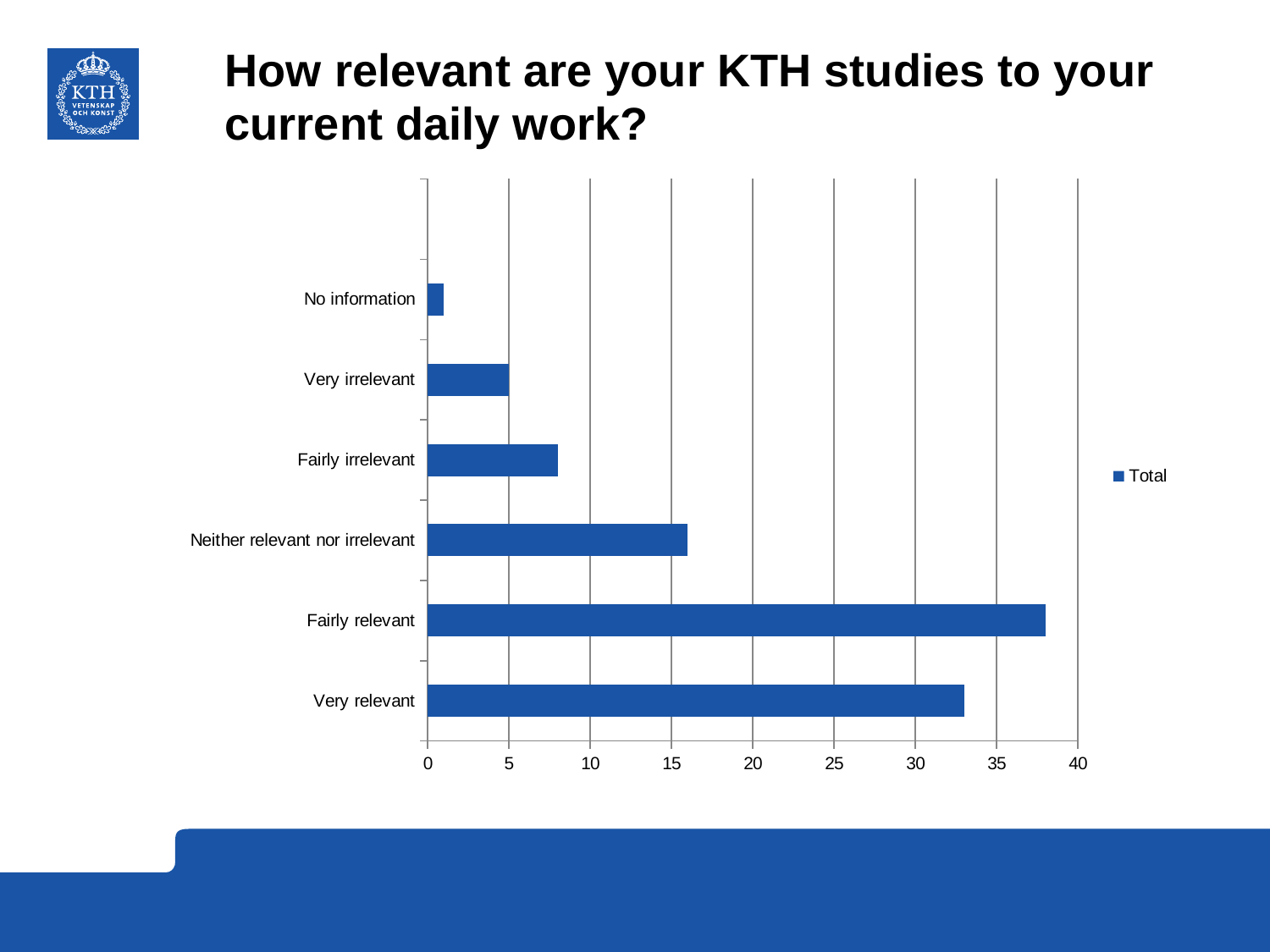
How many categories are shown on the chart? 6 Is the value for Fairly irrelevant greater or less than 10? less How many series does the legend list? 1 Is the value for Neither relevant nor irrelevant greater or less than 15? greater Is the value for Fairly relevant greater or less than 35? greater Which is larger, the value for Fairly irrelevant or the value for Neither relevant nor irrelevant? Neither relevant nor irrelevant Which category has the highest value? Fairly relevant Which category has the lowest value? No information Which is larger, the value for Fairly relevant or the value for Very relevant? Fairly relevant What is the name of the series shown in the legend? Total What kind of chart is shown on the slide? bar chart